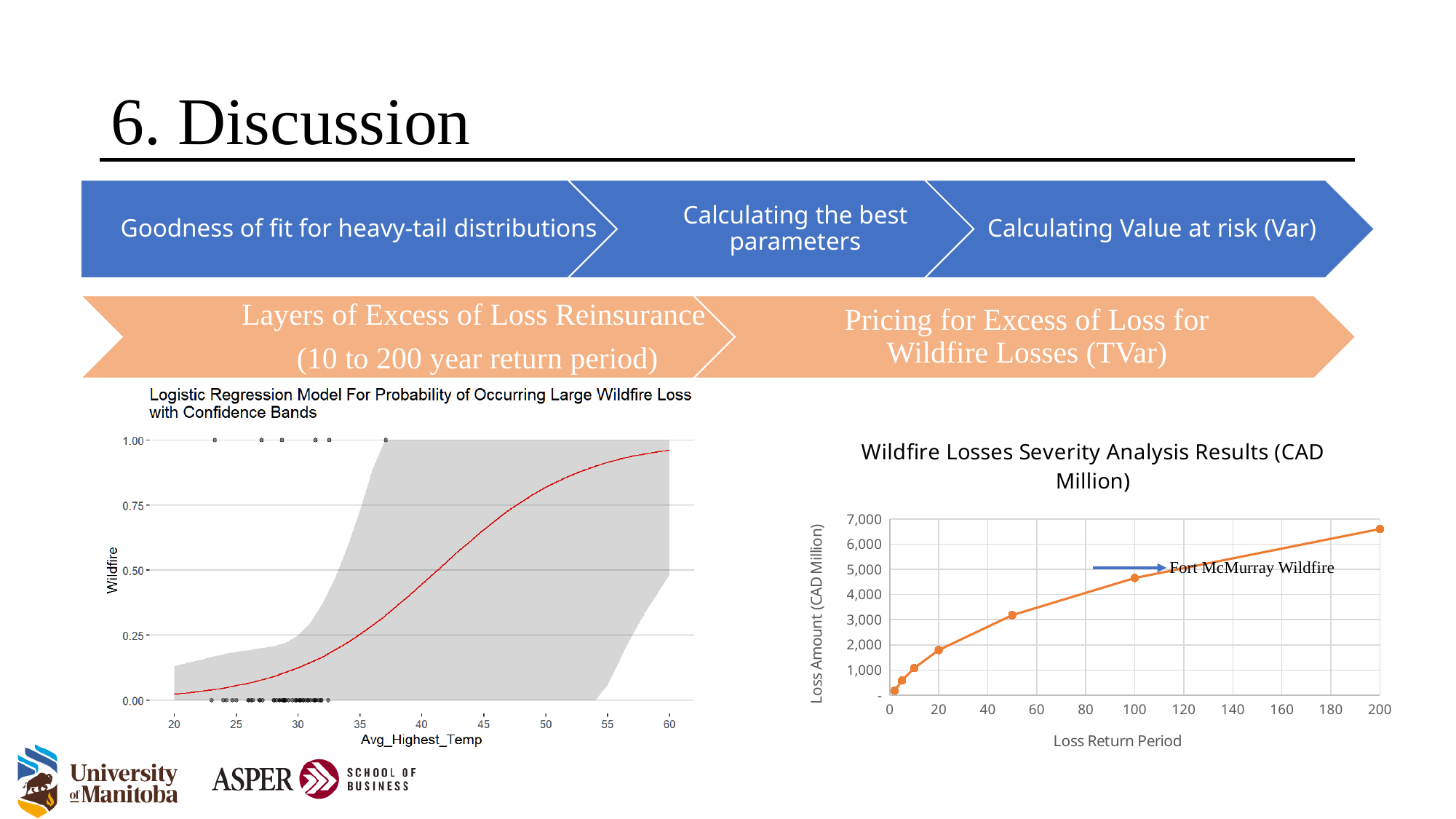
In the 'Wildfire Losses Severity Analysis Results (CAD Million)' chart, does the loss amount rise or fall as the loss return period increases? rise In the logistic regression chart on the left, is the fitted wildfire probability at Avg_Highest_Temp 60 greater or less than 0.75? greater In the 'Wildfire Losses Severity Analysis Results (CAD Million)' chart, how many data points are plotted? 7 In the 'Wildfire Losses Severity Analysis Results (CAD Million)' chart, is the loss amount at a 100-year return period greater or less than 4,000? greater In the 'Wildfire Losses Severity Analysis Results (CAD Million)' chart, which return period is labelled with the annotation 'Fort McMurray Wildfire'? 100 What is the x-axis title of the 'Wildfire Losses Severity Analysis Results (CAD Million)' chart? Loss Return Period In the 'Wildfire Losses Severity Analysis Results (CAD Million)' chart, is the loss amount at a 200-year return period greater or less than 6,000? greater What type of chart is the 'Wildfire Losses Severity Analysis Results (CAD Million)' chart on the right? line chart In the logistic regression chart on the left, does the fitted probability of wildfire rise or fall as Avg_Highest_Temp increases? rise